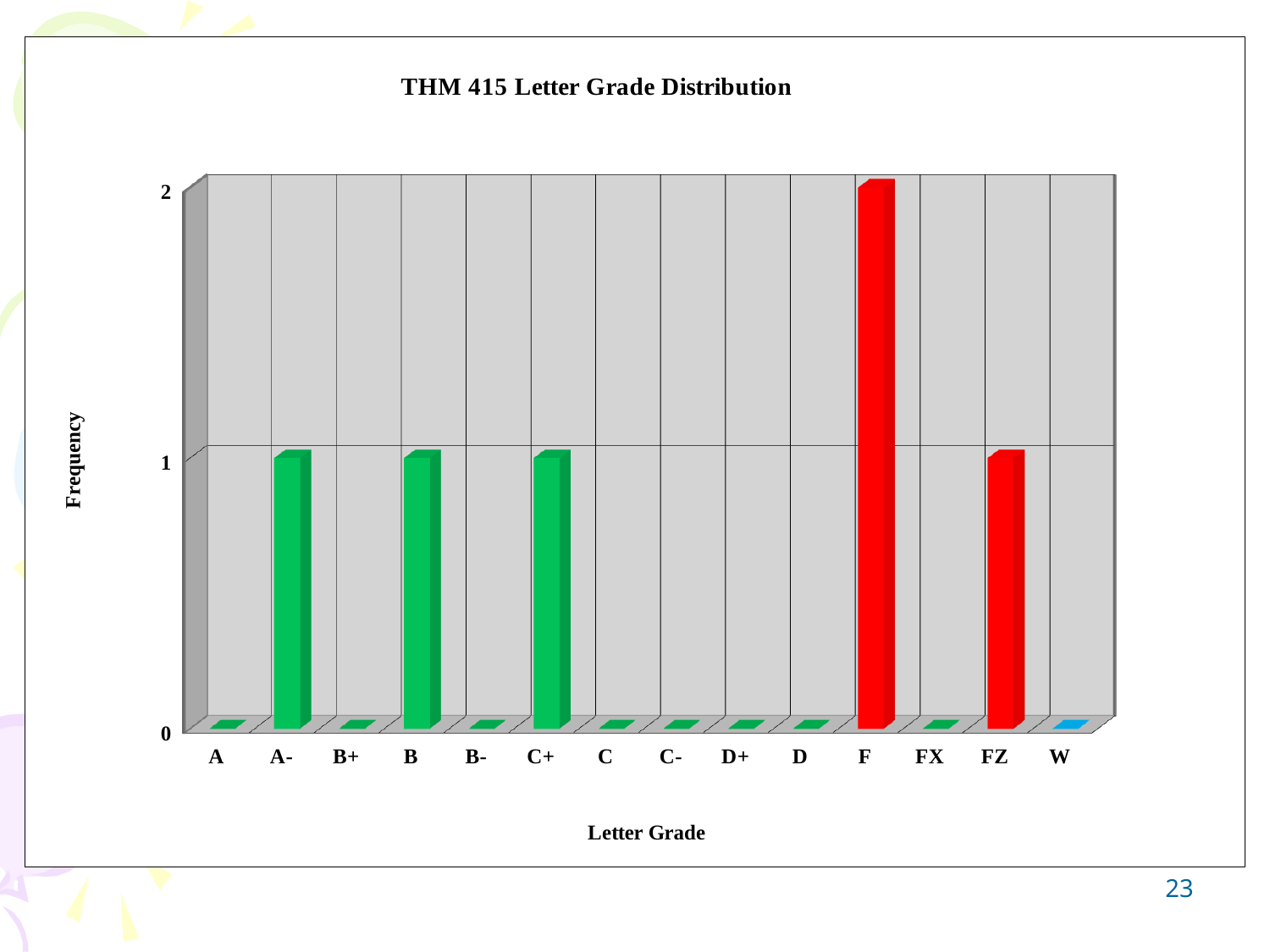
What is the title of the chart? THM 415 Letter Grade Distribution How many letter grade categories are shown on the x axis? 14 What kind of chart is shown on the slide? Bar chart What is the frequency for letter grade A-? 1 Which has a higher frequency, B or C? B How many letter grades have a frequency of 1? 4 Which letter grade has the highest frequency? F What is the label of the vertical axis? Frequency What is the difference between the frequency for F and the frequency for FZ? 1 What is the frequency for letter grade F? 2 What is the frequency for letter grade FZ? 1 What is the frequency for letter grade A? 0